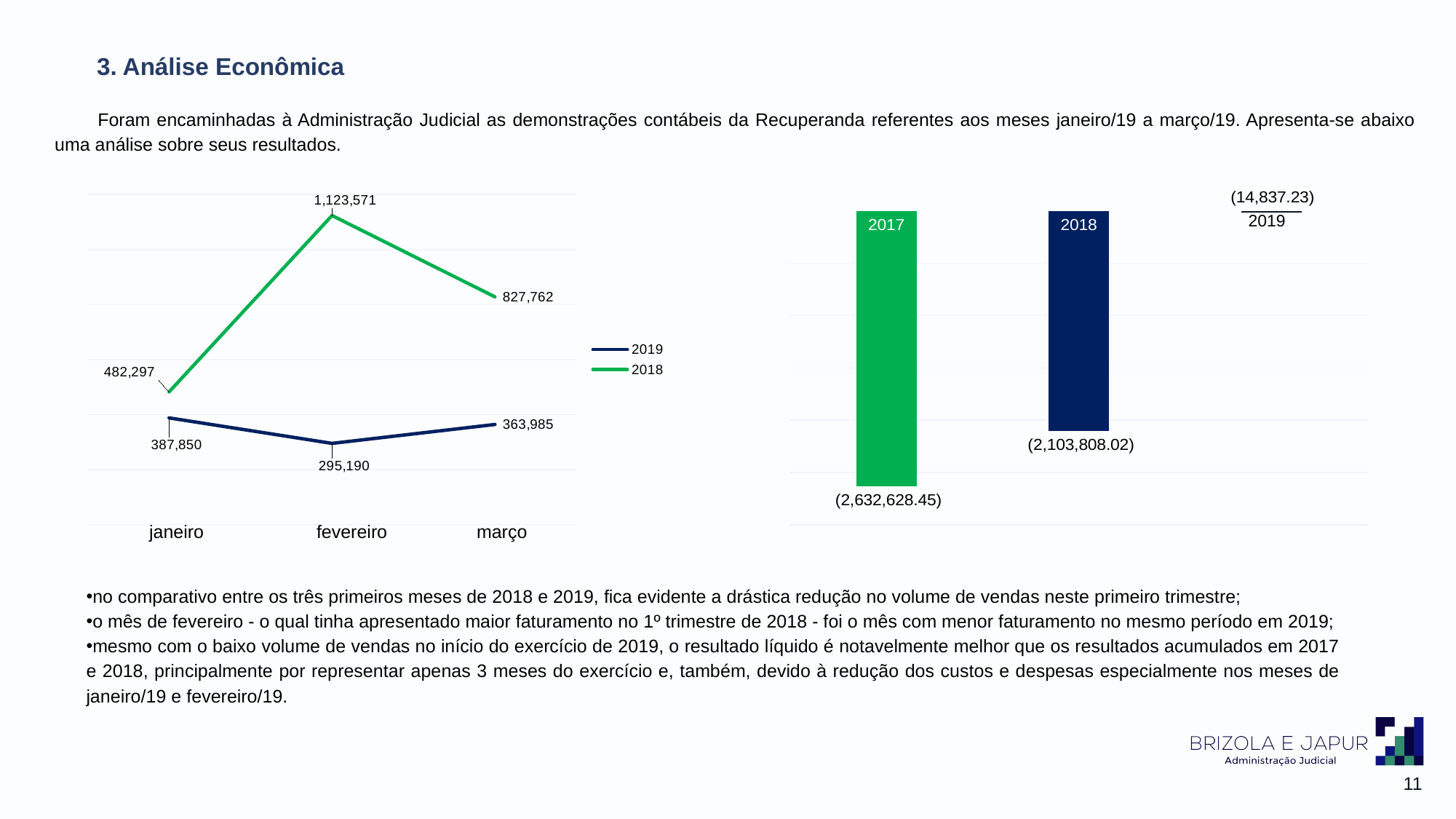
In the line chart on the left, which month has the lowest value in the 2019 series? fevereiro In the line chart on the left, how many series does the legend list? 2 In the bar chart on the right, what is the value for 2017? (2,632,628.45) In the line chart on the left, what is the difference between the 2018 and 2019 values for janeiro? 94,447 In the line chart on the left, which colour is used for the 2018 series? green In the line chart on the left, which month has the highest value in the 2018 series? fevereiro In the bar chart on the right, what is the value for 2019? (14,837.23) In the line chart on the left, do the 2018 values rise or fall from fevereiro to março? fall What kind of chart is shown on the right side of the slide? bar chart In the line chart on the left, what is the value for fevereiro in the 2018 series? 1,123,571 In the line chart on the left, what is the value for março in the 2019 series? 363,985 In the line chart on the left, how many months are plotted on the x axis? 3